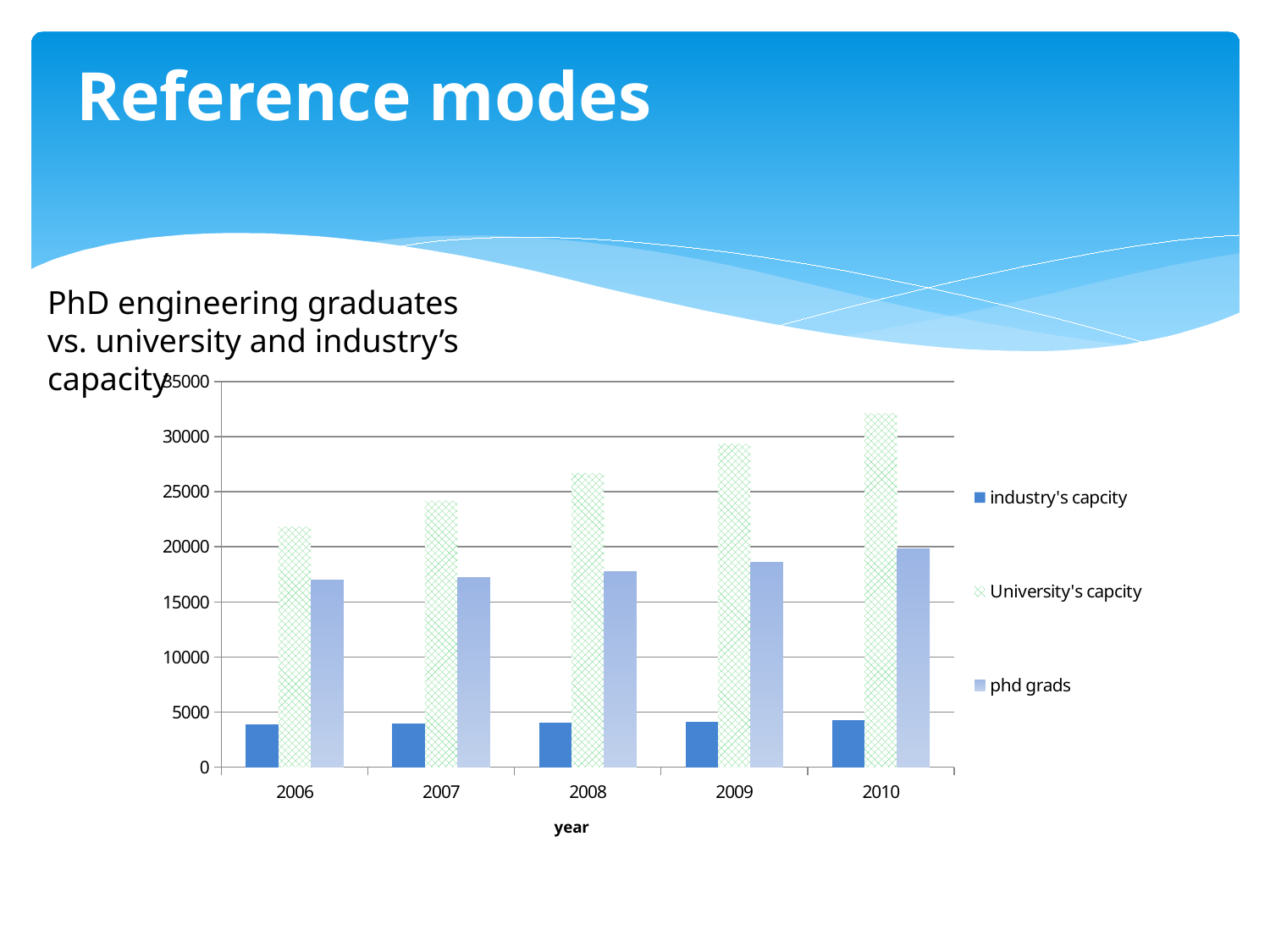
How many years are shown on the x axis? 5 Is the value for industry's capcity in 2006 greater or less than 5000? less Which year has the highest value for University's capcity? 2010 Do the values for University's capcity rise or fall from 2006 to 2010? rise Which is larger in 2009, University's capcity or phd grads? University's capcity What kind of chart is shown on the slide? bar chart Is the value for University's capcity in 2010 greater or less than 30000? greater Is the value for University's capcity in 2008 greater or less than 25000? greater How many series does the legend list? 3 Which year has the lowest value for University's capcity? 2006 What is the label of the x axis? year